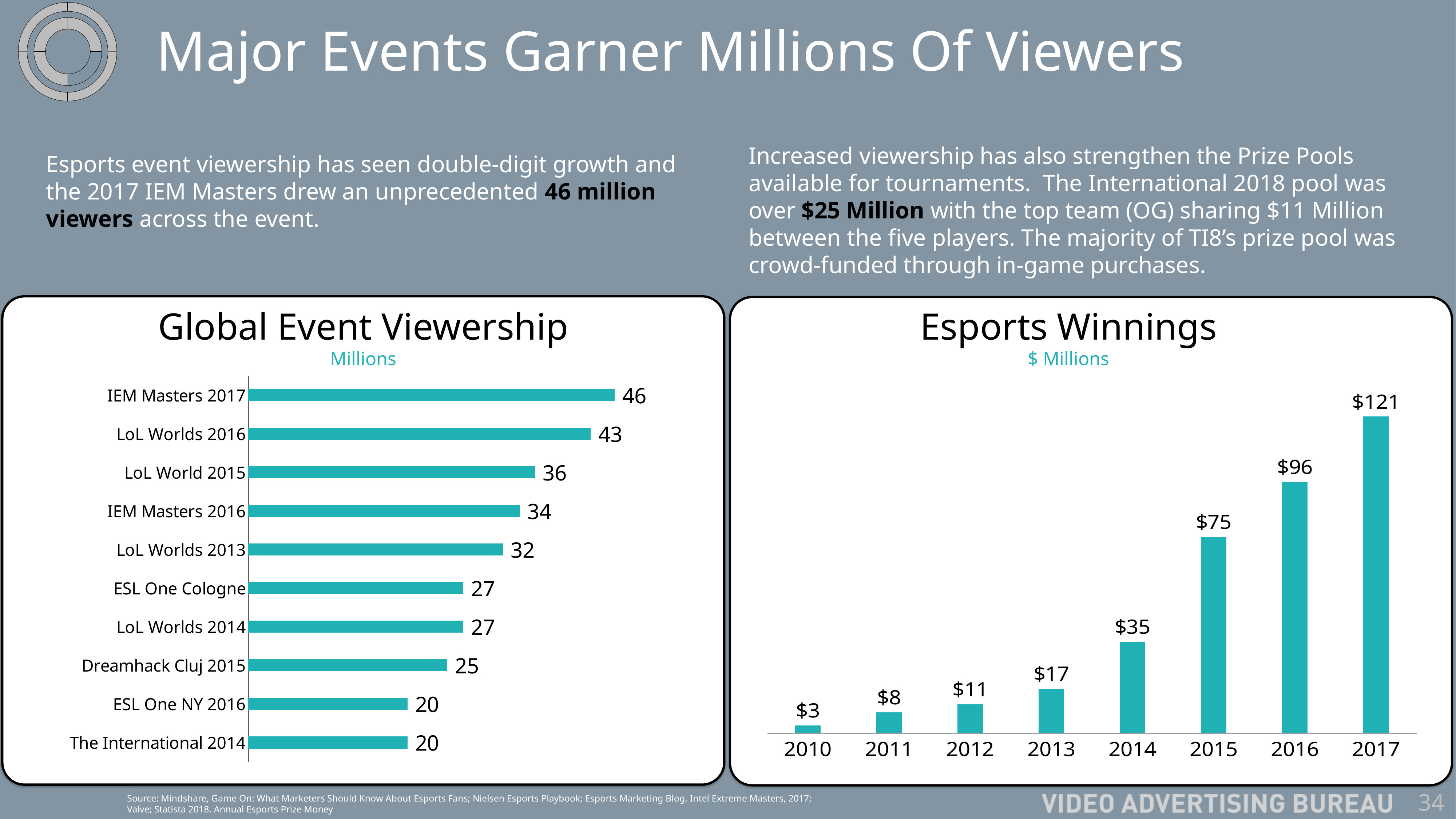
In the Global Event Viewership chart, what is the value for LoL Worlds 2016? 43 In the Esports Winnings chart, which year has the lowest value? 2010 What kind of chart is the Global Event Viewership chart? Bar chart How many events are shown in the Global Event Viewership chart? 10 In the Esports Winnings chart, what is the difference between 2017 and 2016? $25 In the Global Event Viewership chart, which event has the highest viewership? IEM Masters 2017 In the Global Event Viewership chart, what is the difference between IEM Masters 2017 and IEM Masters 2016? 12 In the Esports Winnings chart, do the values rise or fall from 2010 to 2017? Rise What unit is shown under the title of the Esports Winnings chart? $ Millions In the Esports Winnings chart, what is the value for 2014? $35 In the Global Event Viewership chart, which is larger: LoL World 2015 or Dreamhack Cluj 2015? LoL World 2015 How many years are shown in the Esports Winnings chart? 8